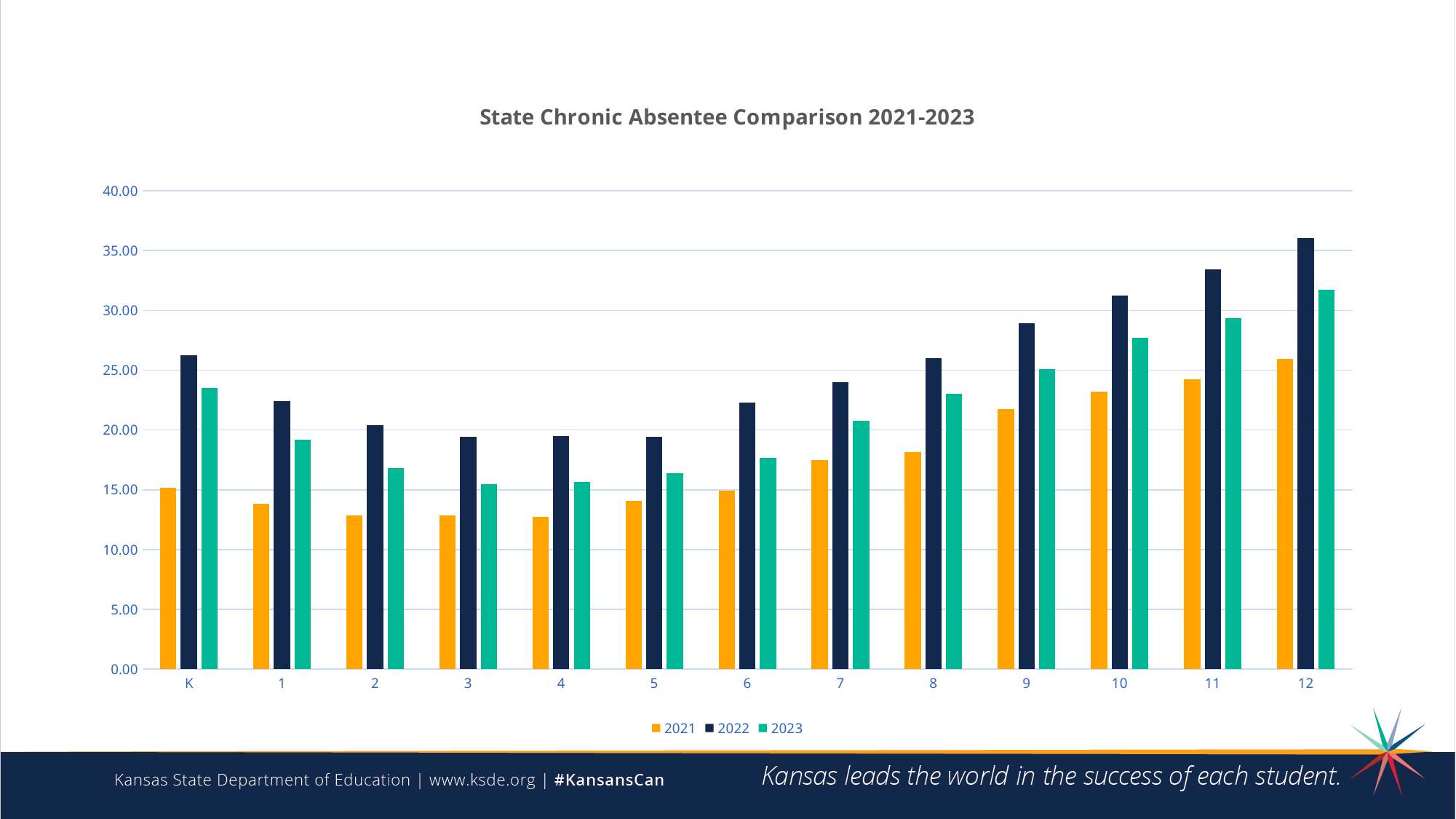
Do the 2022 values rise or fall from grade 5 to grade 12? rise How many grade categories are shown on the x axis? 13 Is the 2022 value for grade 12 greater or less than 35.00? greater Is the 2021 value for K greater or less than 20.00? less What kind of chart is shown on the slide? Bar chart How many series does the legend list? 3 Which grade has the highest value for the 2022 series? 12 What is the title of the chart? State Chronic Absentee Comparison 2021-2023 For grade K, which series has the larger value, 2022 or 2023? 2022 Is the 2023 value for grade 10 greater or less than 25.00? greater Which grade has the highest value for the 2023 series? 12